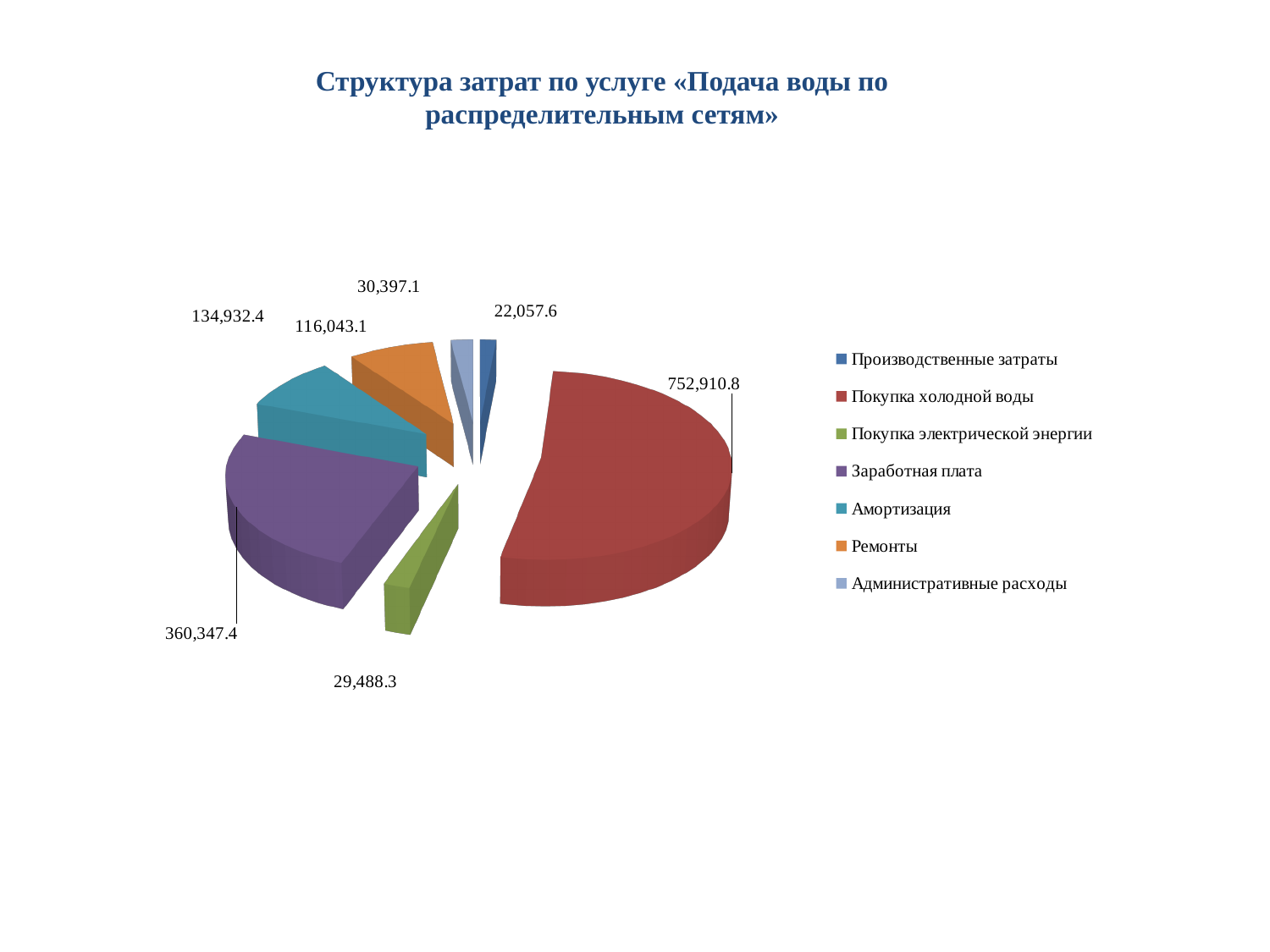
What is the value for Заработная плата? 360,347.4 What is the title of the chart? Структура затрат по услуге «Подача воды по распределительным сетям» What is the difference between Покупка холодной воды and Заработная плата? 392,563.4 What is the value for Покупка холодной воды? 752,910.8 What is the value for Амортизация? 134,932.4 What is the value for Покупка электрической энергии? 29,488.3 Which is larger, Амортизация or Ремонты? Амортизация What type of chart is shown on the slide? Pie chart What is the value for Ремонты? 116,043.1 Which category has the smallest slice of the pie? Производственные затраты Which category has the largest slice of the pie? Покупка холодной воды How many categories does the legend list? 7